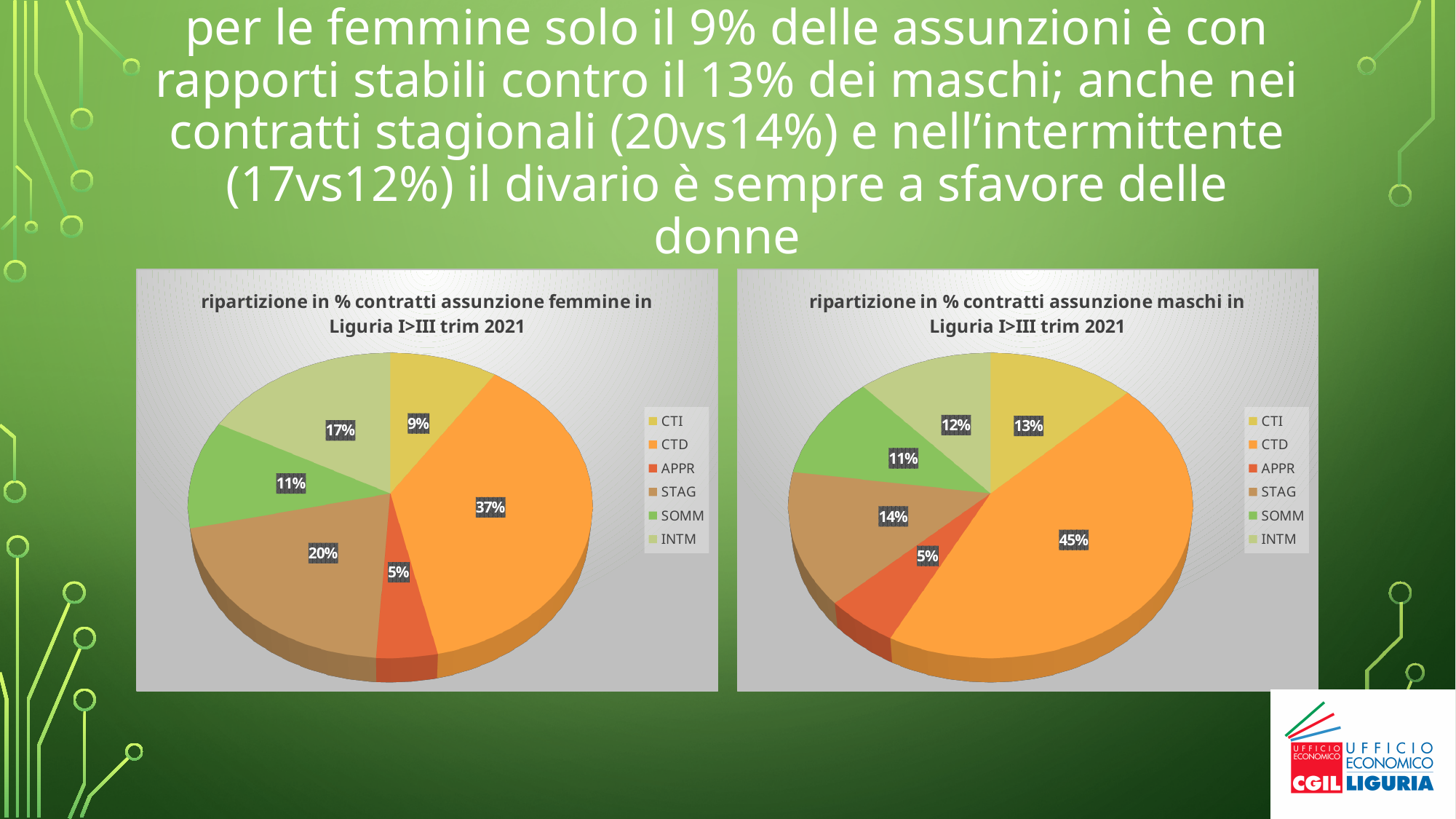
In the left chart (femmine), which contract type has the largest slice? CTD In the right chart (maschi), which contract type has the smallest slice? APPR In the right chart (maschi), what percentage is shown for INTM? 12% Which is larger: the STAG share in the left chart (femmine) or the STAG share in the right chart (maschi)? femmine (20%) What is the difference between the CTD share in the right chart (maschi) and the CTD share in the left chart (femmine)? 8% What is the title of the right chart? ripartizione in % contratti assunzione maschi in Liguria I>III trim 2021 In the left chart (femmine), what percentage is shown for STAG? 20% How many slices does the left chart (femmine) have? 6 In the right chart (maschi), what share of hires is CTD? 45% In the left chart (femmine), what share of hires is CTD? 37% How many entries does the legend of the right chart (maschi) list? 6 What type of chart is used on this slide? Pie chart